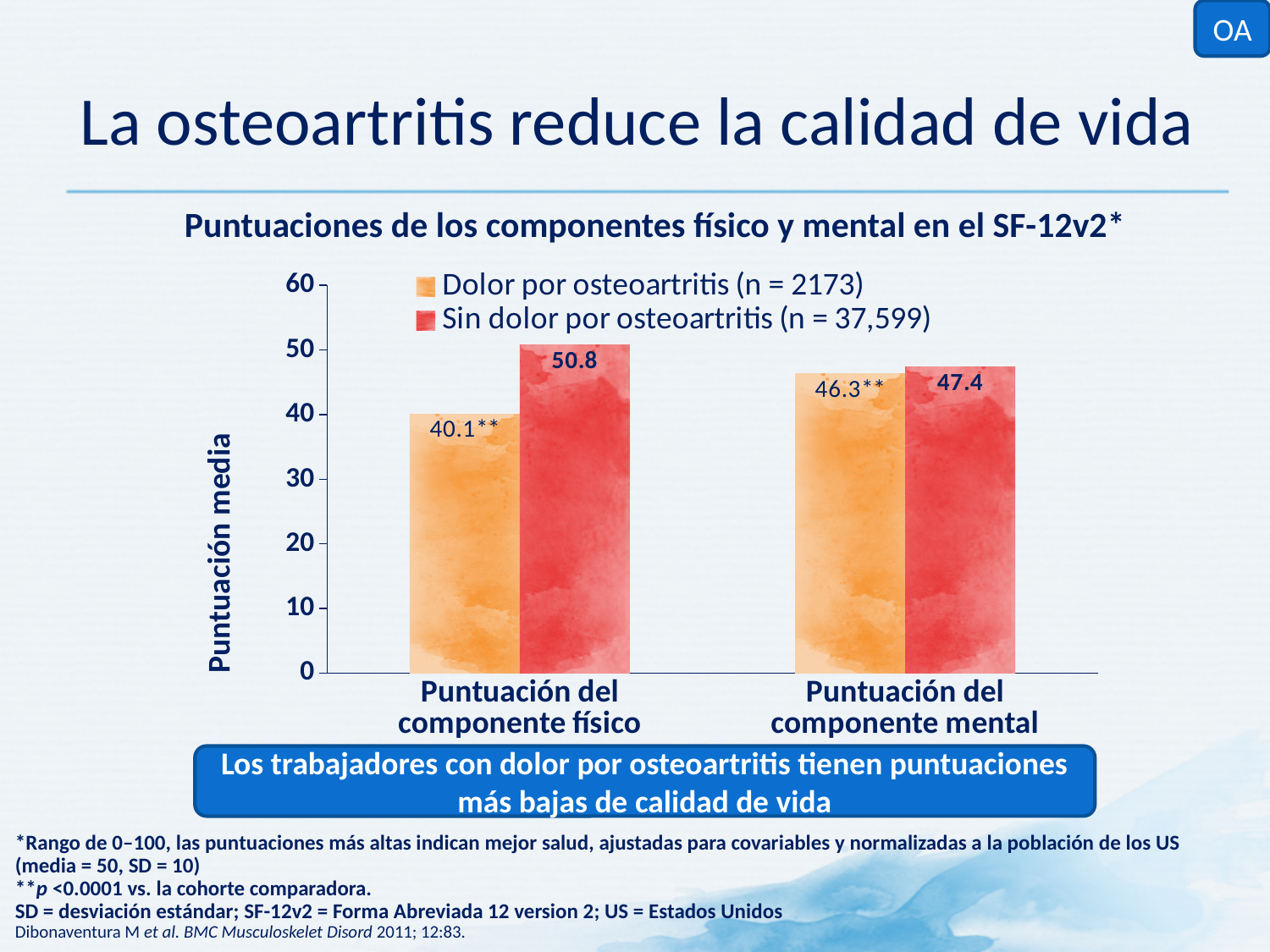
How many series does the legend list? 2 What is the mean score for 'Sin dolor por osteoartritis (n = 37,599)' on 'Puntuación del componente mental'? 47.4 What is the mean score for 'Dolor por osteoartritis (n = 2173)' on 'Puntuación del componente mental'? 46.3 What is the mean score for 'Dolor por osteoartritis (n = 2173)' on 'Puntuación del componente físico'? 40.1 Which is larger: the 'Dolor por osteoartritis' score on the physical component or on the mental component? Puntuación del componente mental What is the difference between the 'Sin dolor por osteoartritis' and 'Dolor por osteoartritis' scores on 'Puntuación del componente físico'? 10.7 Which bar has the highest value in the chart? Sin dolor por osteoartritis, Puntuación del componente físico What type of chart is shown on the slide? Bar chart What is the difference between the 'Sin dolor por osteoartritis' and 'Dolor por osteoartritis' scores on 'Puntuación del componente mental'? 1.1 Which bar has the lowest value in the chart? Dolor por osteoartritis, Puntuación del componente físico How many categories are shown on the x axis? 2 What is the mean score for 'Sin dolor por osteoartritis (n = 37,599)' on 'Puntuación del componente físico'? 50.8